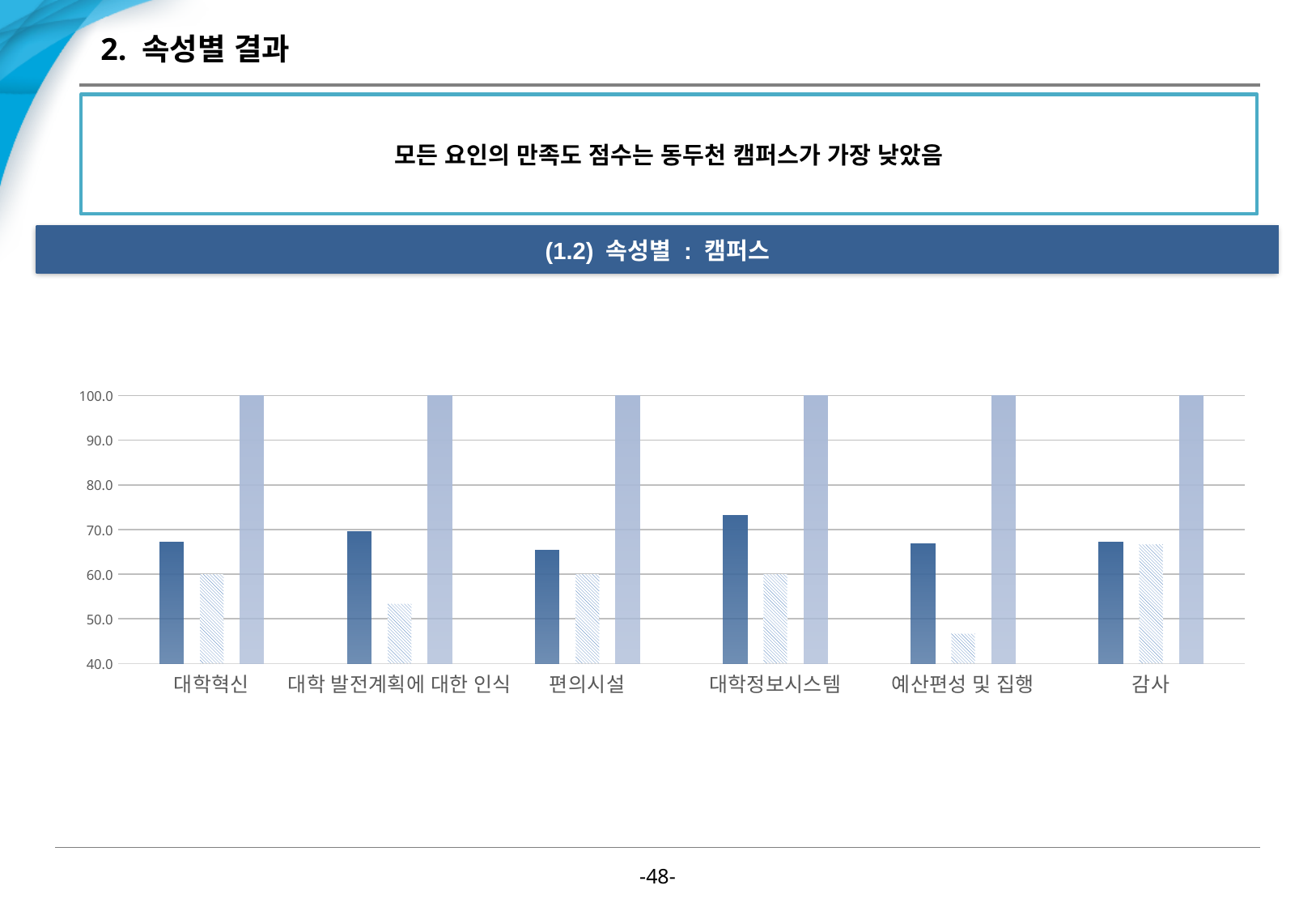
Is the value of the solid dark blue bar for 대학혁신 greater or less than 60? greater Among the solid dark blue bars, which category has the highest value? 대학정보시스템 Among the hatched bars, which category has the lowest value? 예산편성 및 집행 Which is larger: the hatched bar for 감사 or the hatched bar for 편의시설? 감사 What value does the solid light blue bar for 대학혁신 reach? 100.0 Is the value of the solid dark blue bar for 대학정보시스템 greater or less than 70? greater How many categories are shown on the x axis of the chart? 6 How many bars are plotted for each category in the chart? 3 What kind of chart is shown on the slide? bar chart Is the value of the hatched bar for 예산편성 및 집행 greater or less than 50? less What value does the solid light blue bar for 감사 reach? 100.0